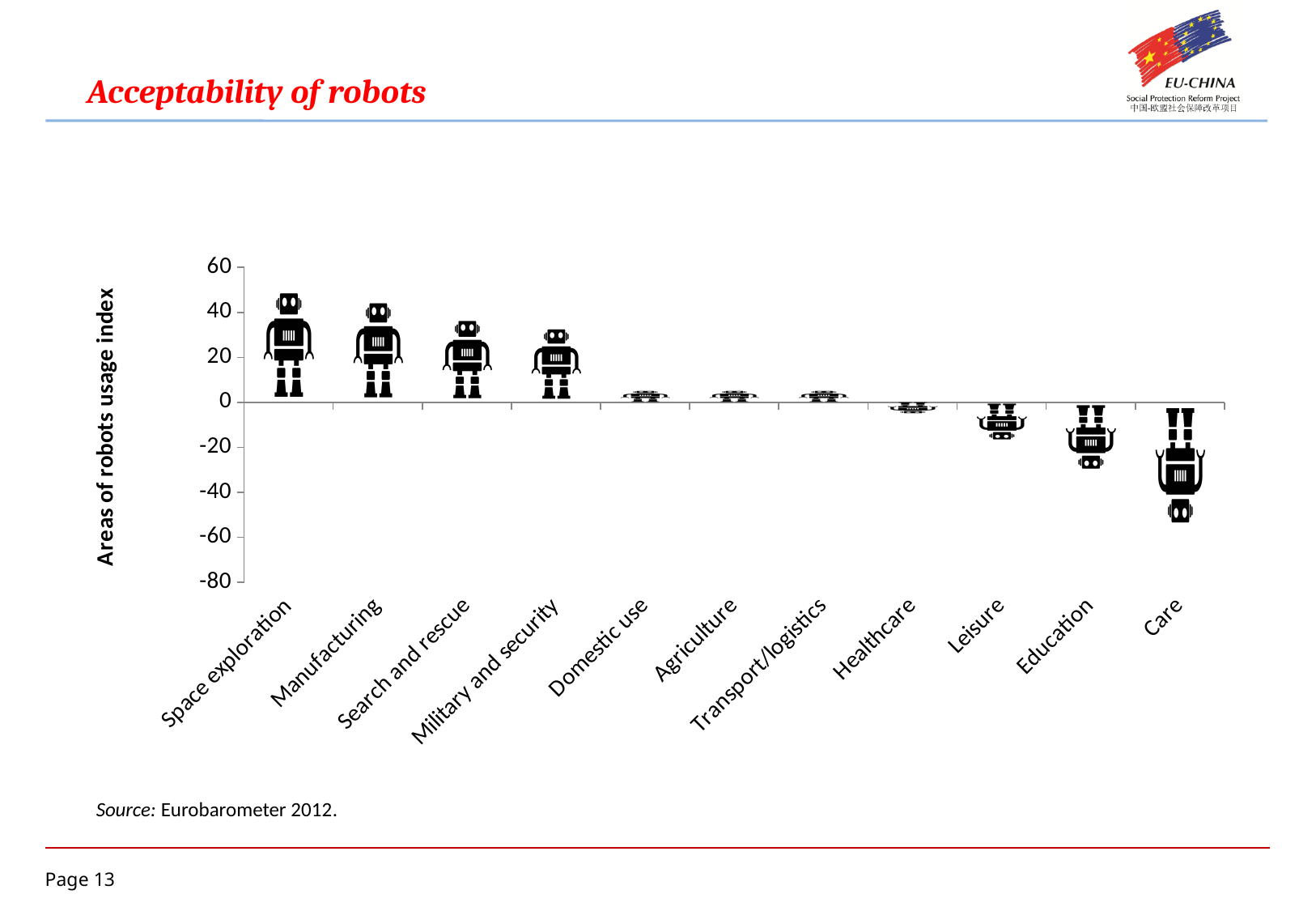
How many categories are shown on the x axis of the chart? 11 Is the value for Space exploration greater or less than 40? greater Is the value for Education greater or less than -20? less Do the values rise or fall moving from left to right along the x axis? fall Which has the larger value, Manufacturing or Search and rescue? Manufacturing What kind of chart is shown on the slide? bar chart Which has the larger value, Leisure or Education? Leisure What is the title of the vertical axis of the chart? Areas of robots usage index Is the value for Military and security greater or less than 20? greater Which category has the lowest value on the areas of robots usage index? Care Which category has the highest value on the areas of robots usage index? Space exploration